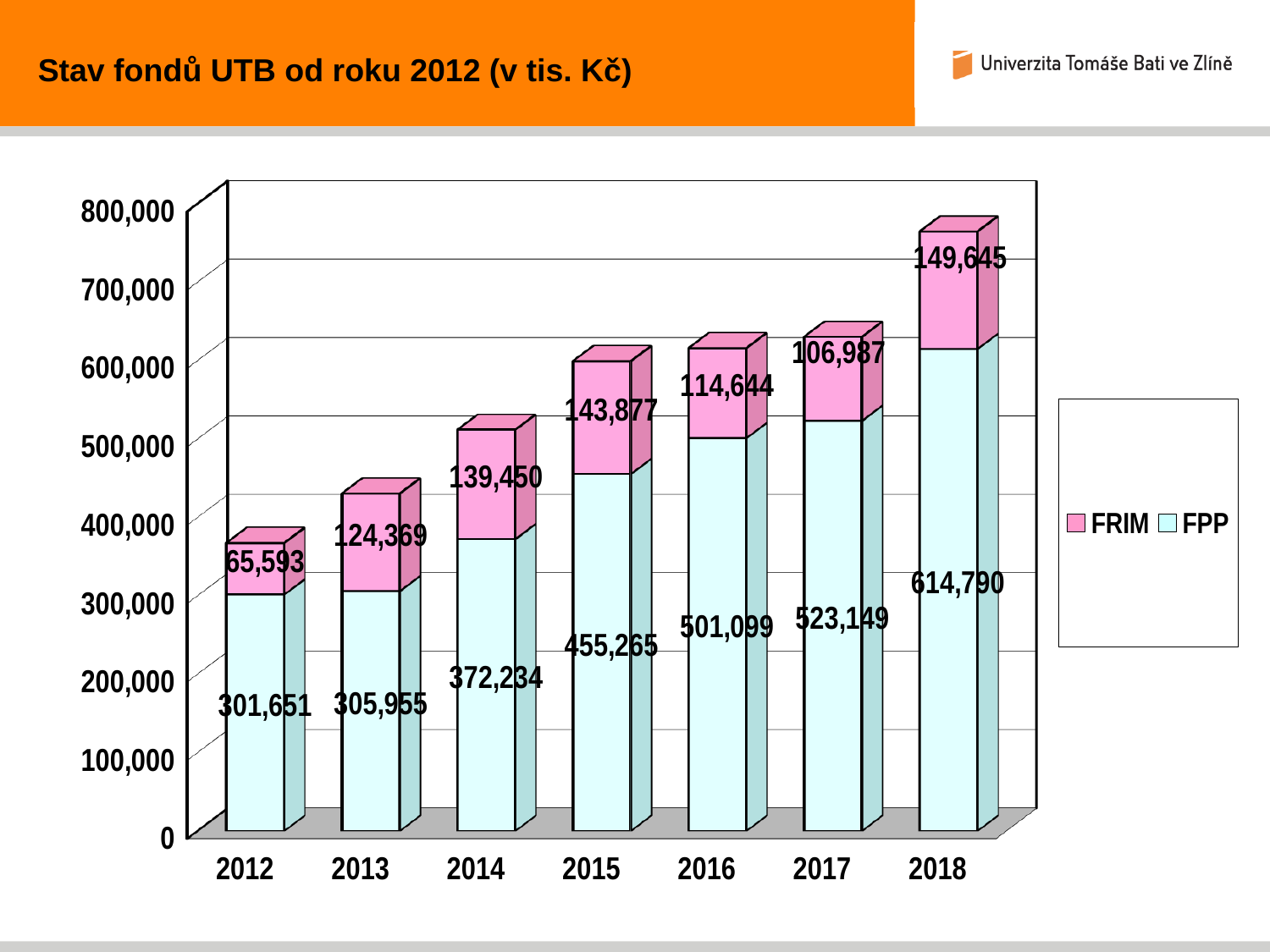
Which is larger, the FRIM value for 2015 or the FRIM value for 2017? 2015 What is the FPP value for 2015? 455,265 Do the FPP values rise or fall from 2012 to 2018? Rise What is the FPP value for 2018? 614,790 What is the FRIM value for 2013? 124,369 How many years are shown on the x axis? 7 What is the total of the stacked bar for 2012? 367,244 What is the difference between the FPP values for 2018 and 2017? 91,641 Which year has the lowest FPP value? 2012 How many series does the legend list? 2 What kind of chart is shown on the slide? Stacked bar chart Which year has the highest FRIM value? 2018